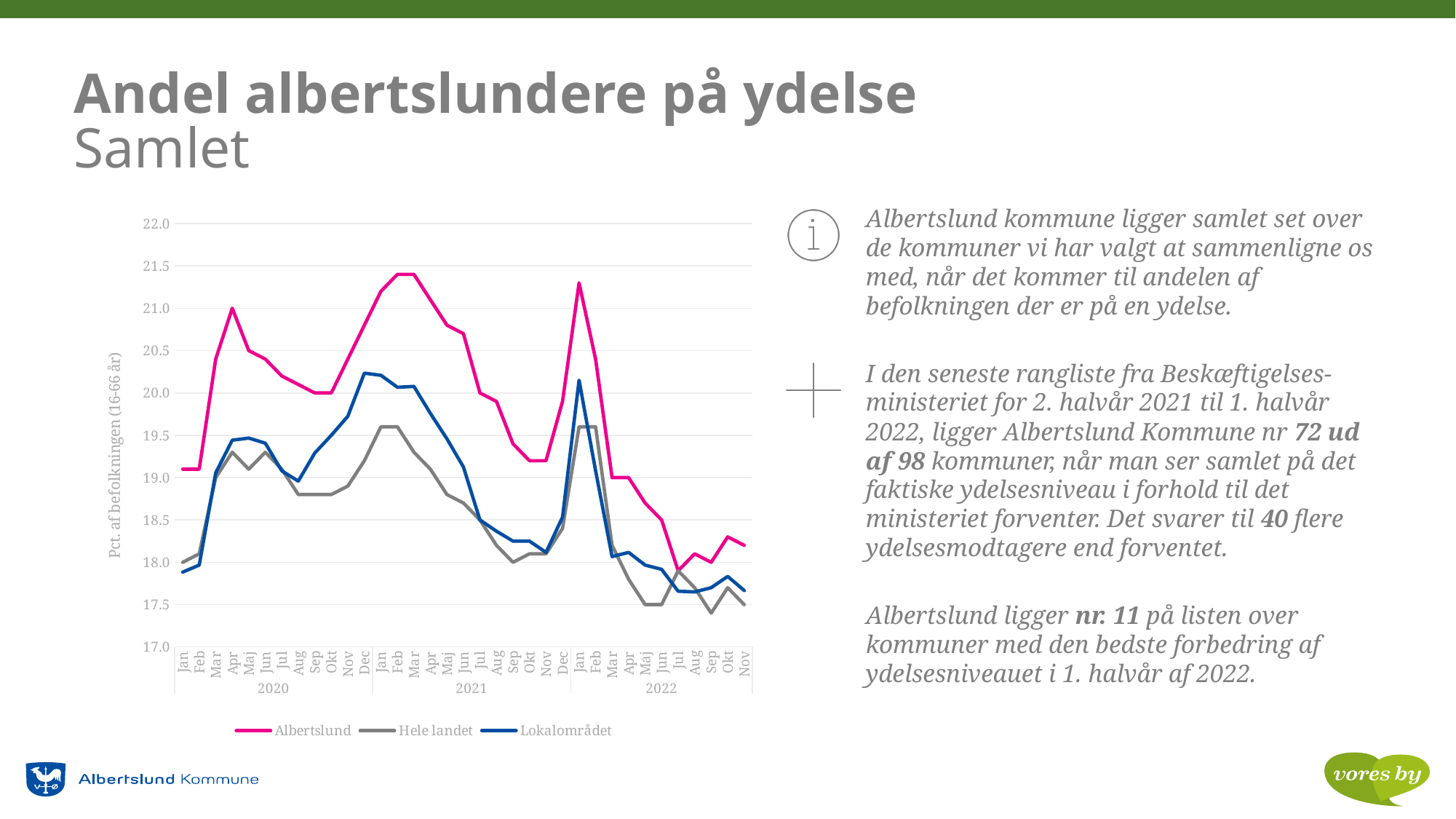
Does the Albertslund line rise or fall from Jan 2022 to Jun 2022? Fall Is the value for Albertslund in Mar 2021 greater or less than 21.0? greater What kind of chart is shown on the slide? Line chart Is the value for Lokalområdet in Jan 2020 greater or less than 18.0? less Which series has the higher value in Dec 2020, Lokalområdet or Hele landet? Lokalområdet Is the value for Albertslund in Nov 2021 greater or less than 19.5? less What is the label of the vertical axis of the chart? Pct. af befolkningen (16-66 år) Which series has the higher value in Jan 2021, Albertslund or Hele landet? Albertslund How many series does the chart legend list? 3 Which series is drawn in pink in the chart? Albertslund Which series has the lowest value in Maj 2022? Hele landet